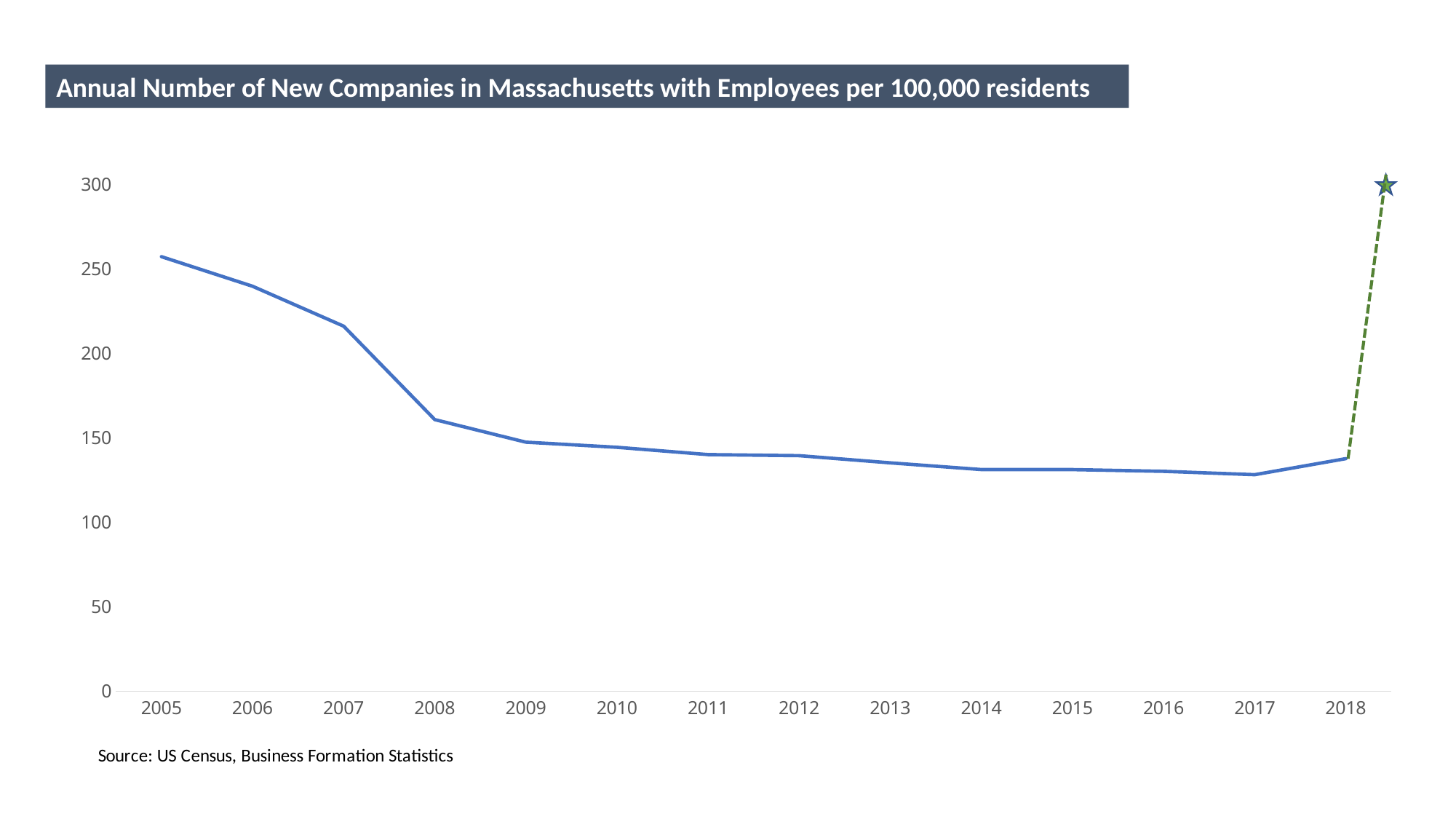
Which year has the highest value on the plotted line? 2005 Does the plotted line generally rise or fall from 2005 to 2017? fall What is the title of the chart? Annual Number of New Companies in Massachusetts with Employees per 100,000 residents Is the value for 2008 greater or less than 150? greater What is the source cited below the chart? US Census, Business Formation Statistics How many years are plotted along the x axis? 14 Is the value for 2007 greater or less than 200? greater Which is larger, the value for 2018 or the value for 2005? 2005 What kind of chart is shown on the slide? line chart Which is larger, the value for 2007 or the value for 2008? 2007 Is the value for 2005 greater or less than 250? greater